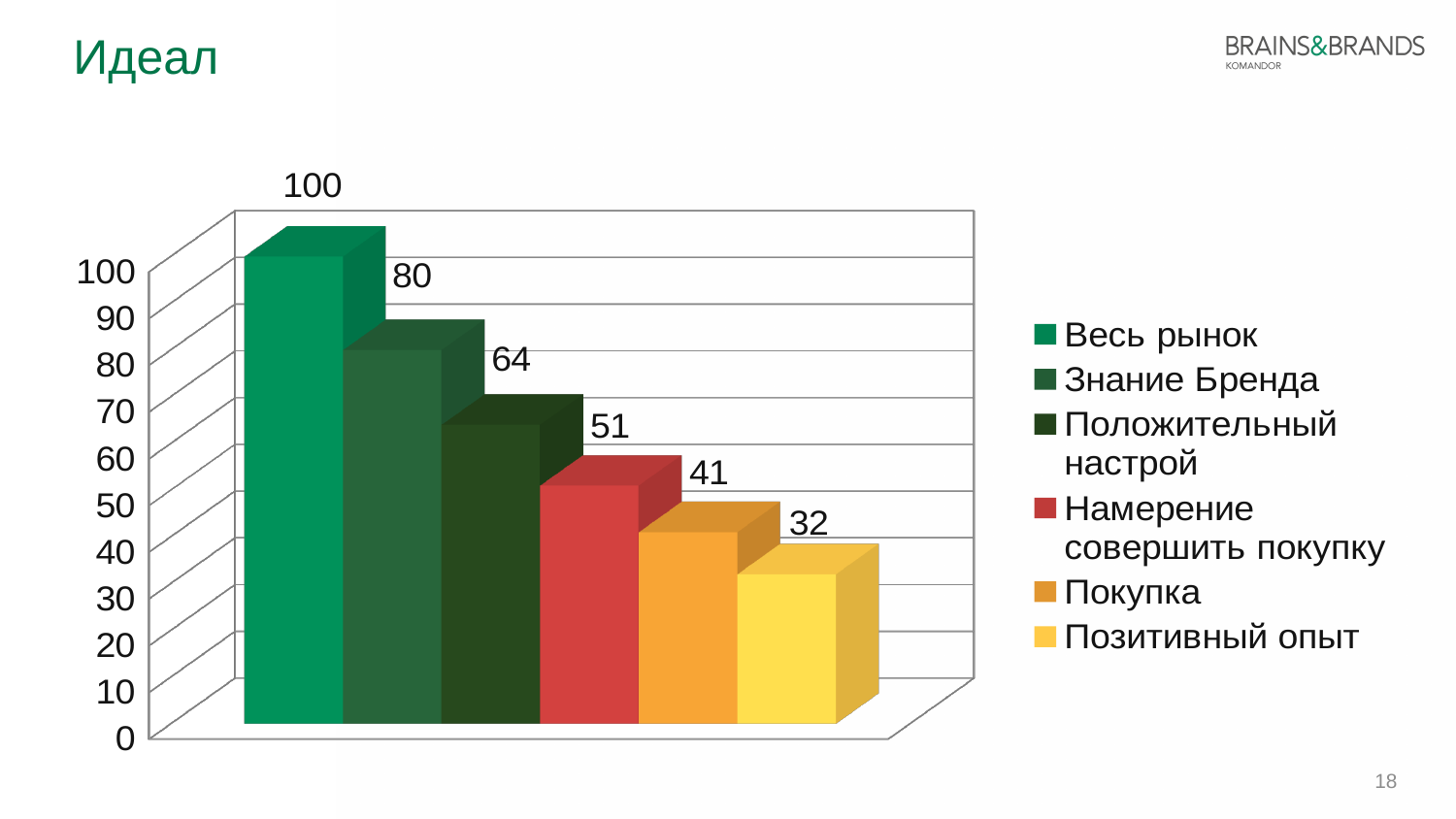
Which series has the highest value? Весь рынок What is the value for Покупка? 41 How many series does the legend list? 6 What is the value for Знание Бренда? 80 What is the value for Намерение совершить покупку? 51 What is the value for Позитивный опыт? 32 What kind of chart is shown on the slide? Bar chart Which series has the lowest value? Позитивный опыт Which is larger, the value for Положительный настрой or the value for Намерение совершить покупку? Положительный настрой What is the difference between the values for Знание Бренда and Покупка? 39 What is the value for Положительный настрой? 64 What is the value for Весь рынок? 100